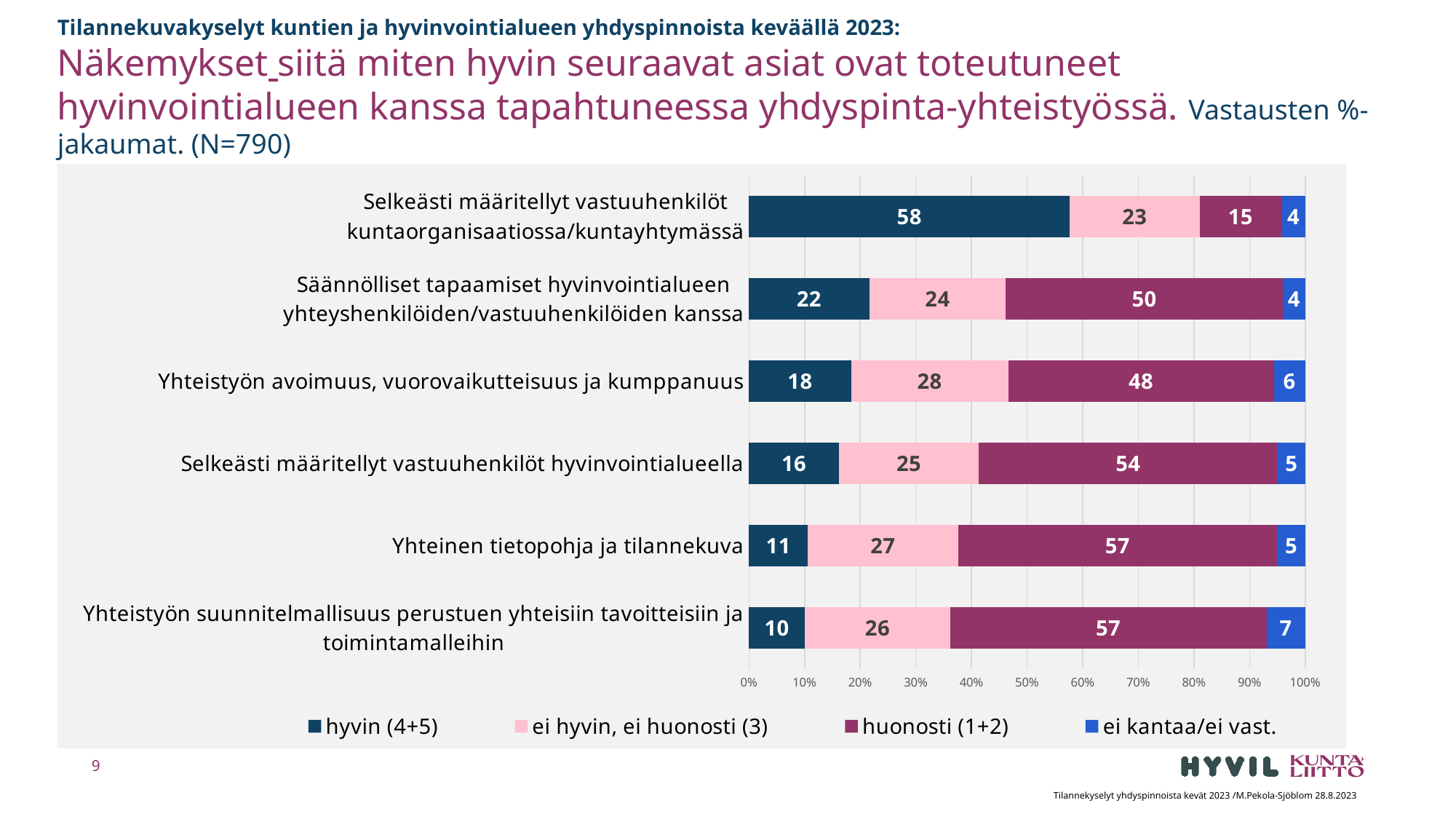
How many series does the legend list? 4 What is the 'ei hyvin, ei huonosti (3)' value for 'Yhteistyön avoimuus, vuorovaikutteisuus ja kumppanuus'? 28 What kind of chart is shown on the slide? Stacked bar chart What is the difference between the 'huonosti (1+2)' values for 'Yhteinen tietopohja ja tilannekuva' and 'Yhteistyön avoimuus, vuorovaikutteisuus ja kumppanuus'? 9 What is the total of the stacked bar for 'Yhteinen tietopohja ja tilannekuva'? 100 Which category has the highest 'hyvin (4+5)' value? Selkeästi määritellyt vastuuhenkilöt kuntaorganisaatiossa/kuntayhtymässä Which category has the lowest 'hyvin (4+5)' value? Yhteistyön suunnitelmallisuus perustuen yhteisiin tavoitteisiin ja toimintamalleihin What is the 'ei kantaa/ei vast.' value for 'Yhteistyön suunnitelmallisuus perustuen yhteisiin tavoitteisiin ja toimintamalleihin'? 7 What is the 'hyvin (4+5)' value for 'Selkeästi määritellyt vastuuhenkilöt kuntaorganisaatiossa/kuntayhtymässä'? 58 How many categories are plotted on the chart? 6 Which is larger: the 'hyvin (4+5)' value for 'Säännölliset tapaamiset hyvinvointialueen yhteyshenkilöiden/vastuuhenkilöiden kanssa' or for 'Selkeästi määritellyt vastuuhenkilöt hyvinvointialueella'? Säännölliset tapaamiset hyvinvointialueen yhteyshenkilöiden/vastuuhenkilöiden kanssa What is the 'huonosti (1+2)' value for 'Säännölliset tapaamiset hyvinvointialueen yhteyshenkilöiden/vastuuhenkilöiden kanssa'? 50